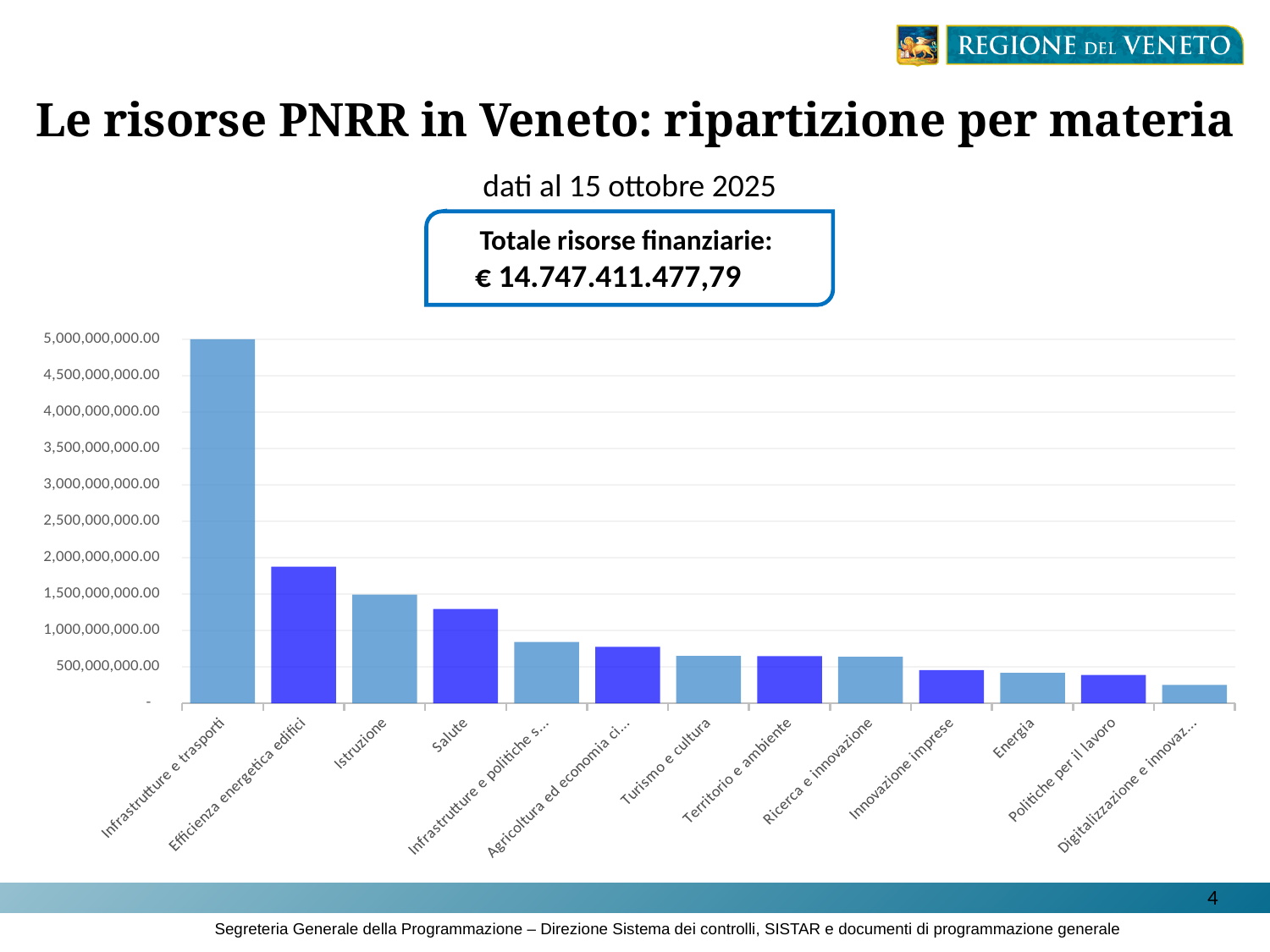
Is the value for Efficienza energetica edifici greater or less than 1,500,000,000.00? greater Is the value for Salute greater or less than 1,000,000,000.00? greater Is the value for Infrastrutture e trasporti greater or less than 4,500,000,000.00? greater What total financial resources figure is shown in the box above the chart? € 14.747.411.477,79 Which has a larger value, Istruzione or Salute? Istruzione Which category has the highest value in the chart? Infrastrutture e trasporti How many categories (bars) does the chart show? 13 What kind of chart is shown on the slide? bar chart Do the bar values rise or fall from left to right along the x axis? fall